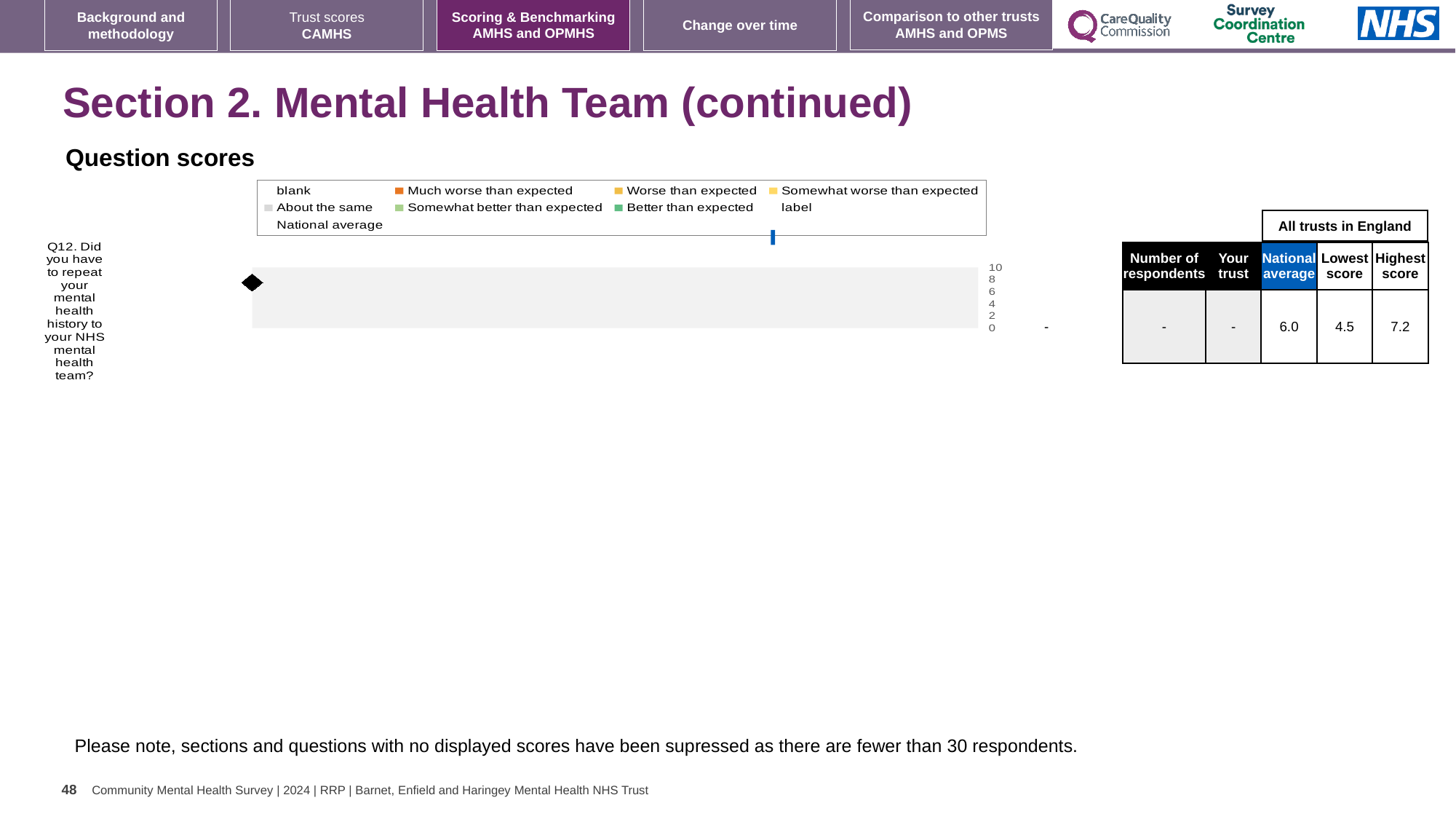
What kind of chart is shown under 'Question scores'? bar chart Which survey question is the category shown on the chart's vertical axis? Q12. Did you have to repeat your mental health history to your NHS mental health team? In the table beside the chart, what is the highest score among all trusts in England for Q12? 7.2 How many survey questions are plotted as categories in the chart? 1 In the table beside the chart, what is the national average score for Q12? 6.0 What is the difference between the highest score (7.2) and the lowest score (4.5) shown in the table for Q12? 2.7 What value is shown for 'Your trust' in the table for Q12? - What is the highest tick value shown on the chart's score axis? 10 In the table beside the chart, what is the lowest score among all trusts in England for Q12? 4.5 Is the national average score for Q12 (6.0) greater or less than the lowest score (4.5)? greater